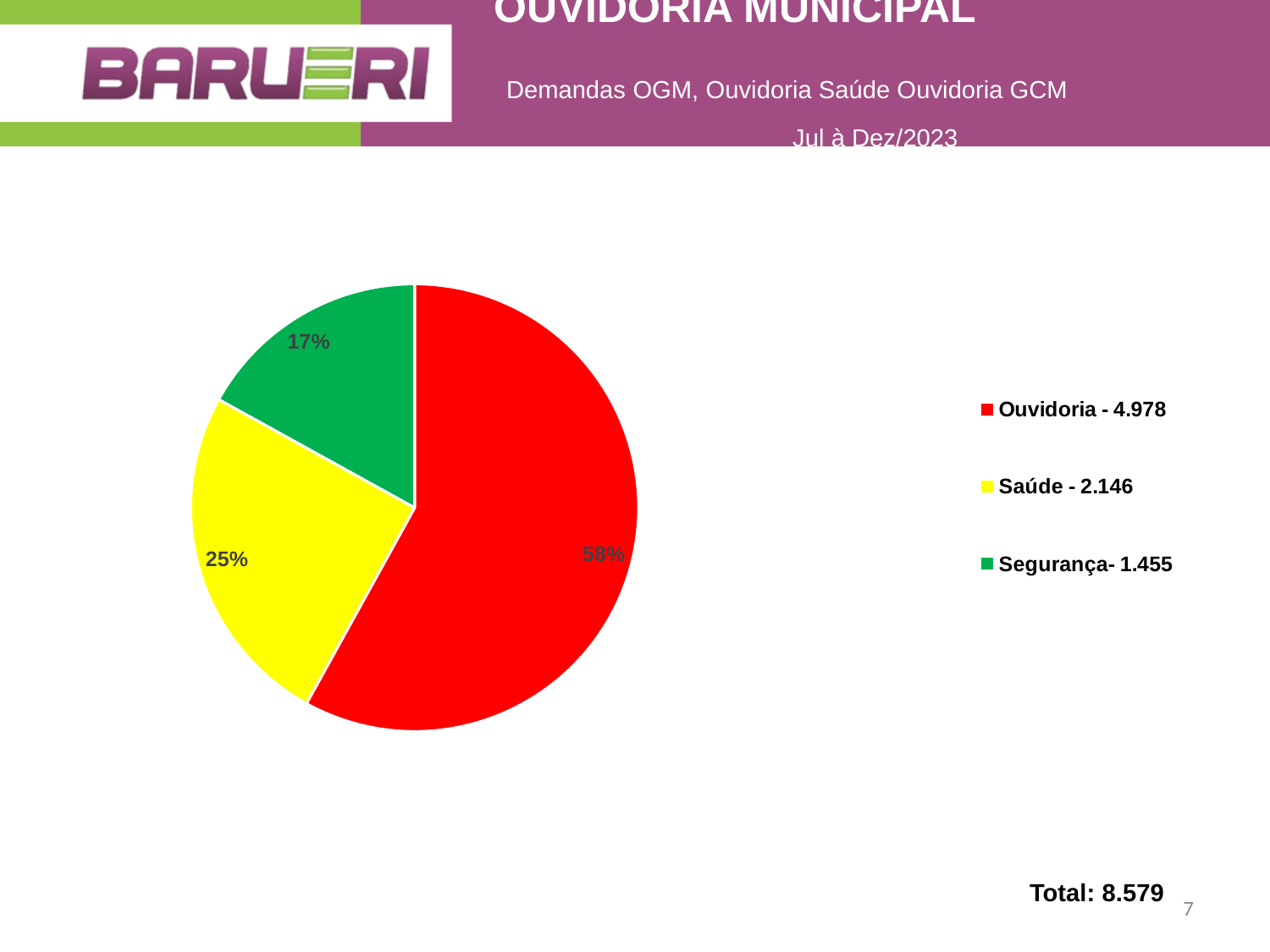
How many entries does the legend list? 3 What percentage share does the Saúde slice have? 25% What percentage share does the Segurança slice have? 17% Which category has the largest slice of the pie? Ouvidoria What percentage share does the Ouvidoria slice have? 58% What kind of chart is shown on the slide? pie chart Which is larger, the Saúde slice or the Segurança slice? Saúde What value is shown in the legend for Segurança? 1.455 How many slices does the pie chart have? 3 Which category has the smallest slice of the pie? Segurança What colour is the Saúde slice? yellow What value is shown in the legend for Ouvidoria? 4.978